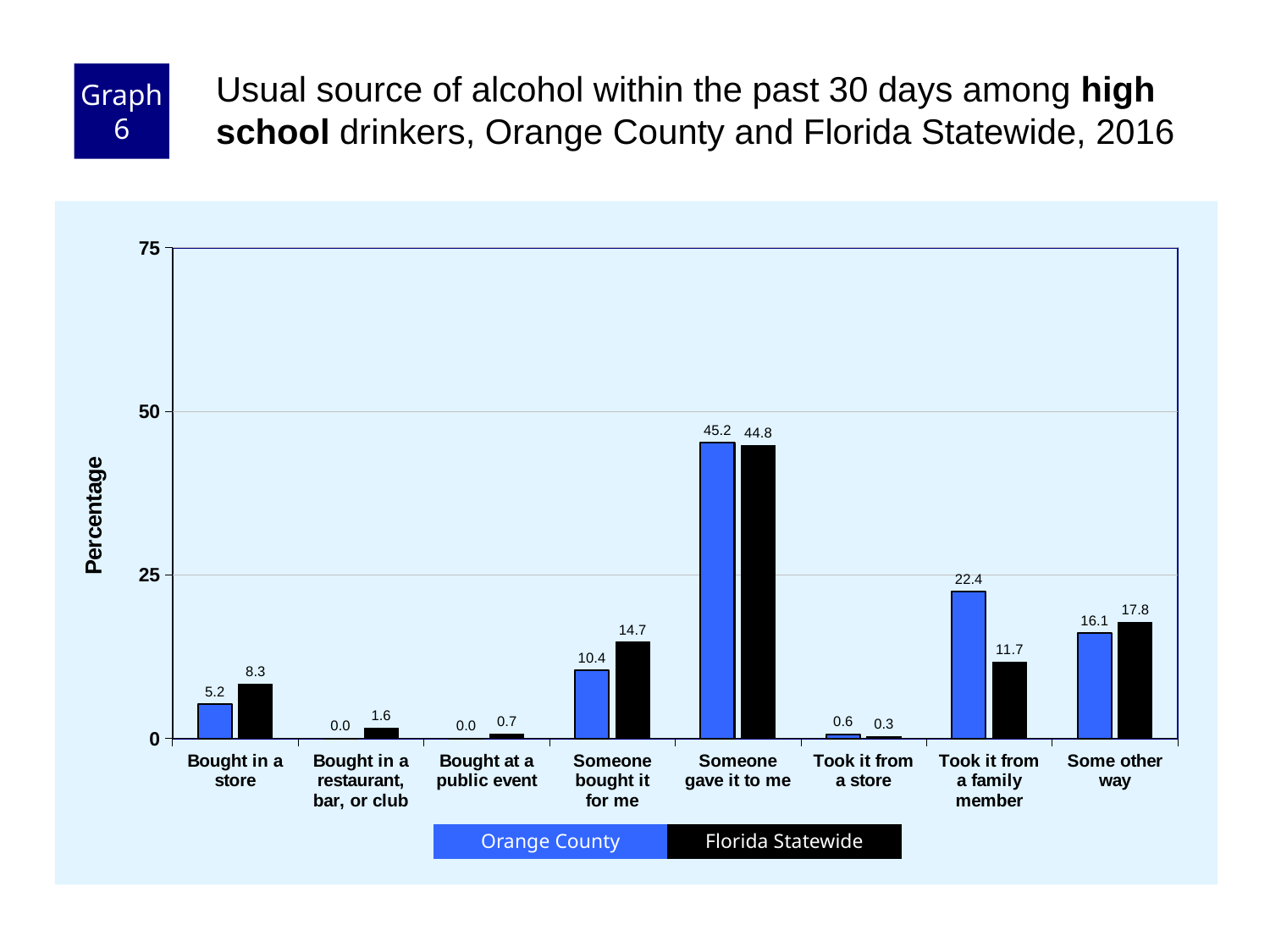
How many series does the legend list? 2 What is the Orange County value for "Someone gave it to me"? 45.2 What is the Orange County value for "Bought in a store"? 5.2 What colour represents Florida Statewide in the chart? black What is the difference between the Orange County and Florida Statewide values for "Took it from a family member"? 10.7 Which category has the highest Florida Statewide value? Someone gave it to me Is the Orange County value for "Someone gave it to me" greater or less than 50? less What is the Florida Statewide value for "Took it from a family member"? 11.7 Which category has the lowest Florida Statewide value? Took it from a store What kind of chart is shown on the slide? bar chart How many categories are shown on the x axis? 8 For "Someone bought it for me", which is larger: Orange County or Florida Statewide? Florida Statewide